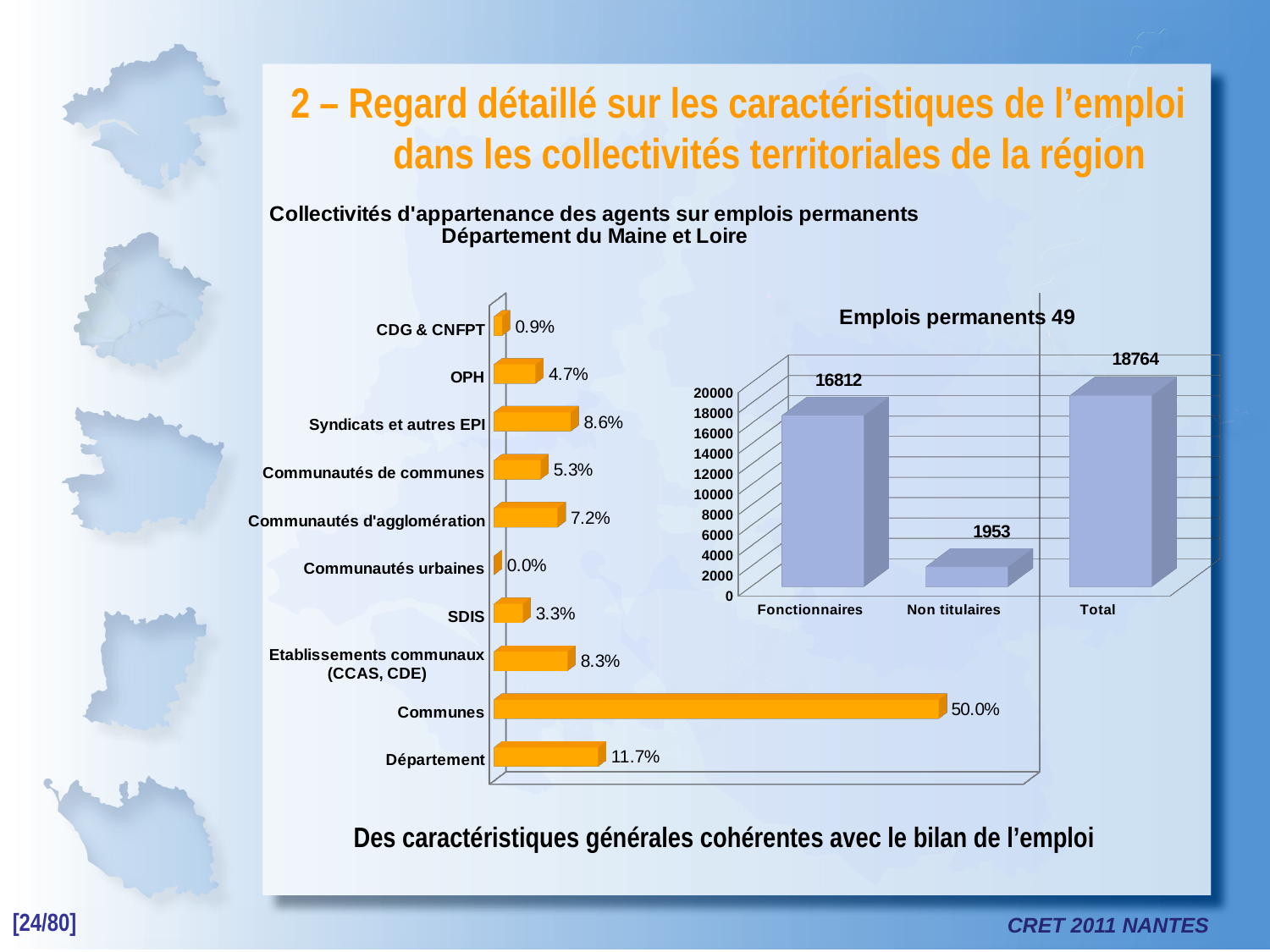
In the chart 'Collectivités d'appartenance des agents sur emplois permanents', what is the value for Communes? 50.0% In the chart 'Collectivités d'appartenance des agents sur emplois permanents', how many categories are shown? 10 In the chart 'Emplois permanents 49', what is the value for Fonctionnaires? 16812 In the chart 'Collectivités d'appartenance des agents sur emplois permanents', which is larger: Département or OPH? Département In the chart 'Emplois permanents 49', how many categories are shown on the x axis? 3 In the chart 'Emplois permanents 49', what is the value for Non titulaires? 1953 In the chart 'Collectivités d'appartenance des agents sur emplois permanents', which category has the highest value? Communes In the chart 'Collectivités d'appartenance des agents sur emplois permanents', which category has the lowest value? Communautés urbaines What kind of chart is the chart 'Emplois permanents 49'? Bar chart In the chart 'Collectivités d'appartenance des agents sur emplois permanents', what is the value for Syndicats et autres EPI? 8.6% In the chart 'Emplois permanents 49', what is the difference between Fonctionnaires and Non titulaires? 14859 In the chart 'Collectivités d'appartenance des agents sur emplois permanents', what is the difference between Communautés d'agglomération and Communautés de communes? 1.9%